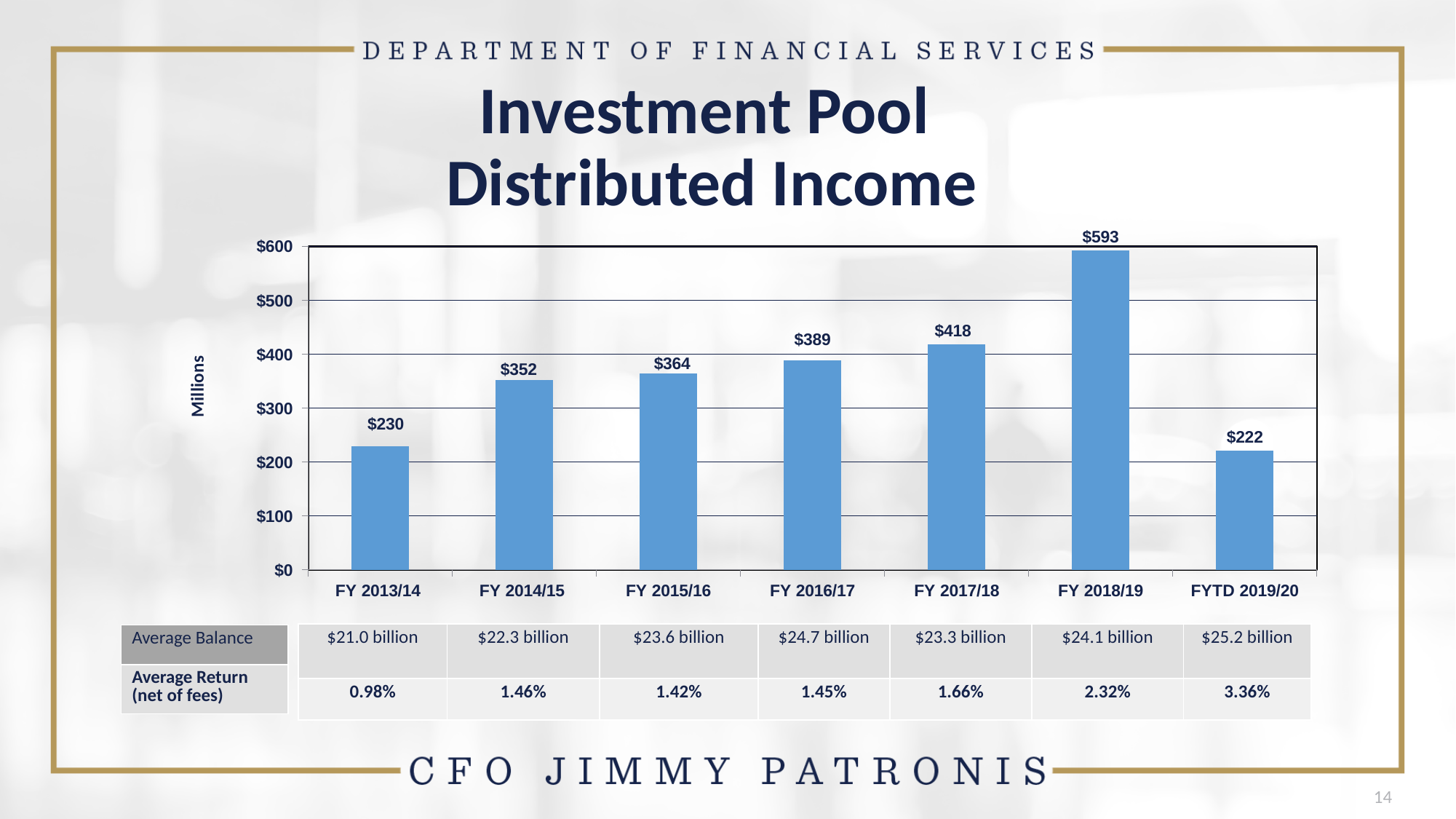
Which fiscal year has the highest distributed income? FY 2018/19 Which fiscal year has the lowest distributed income? FYTD 2019/20 What kind of chart is shown on the slide? Bar chart How many fiscal year categories are shown on the chart? 7 What is the label on the vertical axis of the chart? Millions What is the title of the chart on the slide? Investment Pool Distributed Income Is the value for FY 2017/18 greater or less than $400? greater What is the distributed income value for FY 2013/14? $230 What is the distributed income value for FY 2016/17? $389 Do the distributed income values rise or fall from FY 2013/14 to FY 2018/19? Rise What is the difference between the distributed income for FY 2018/19 and FY 2017/18? $175 Which is larger, the distributed income for FY 2014/15 or FY 2015/16? FY 2015/16